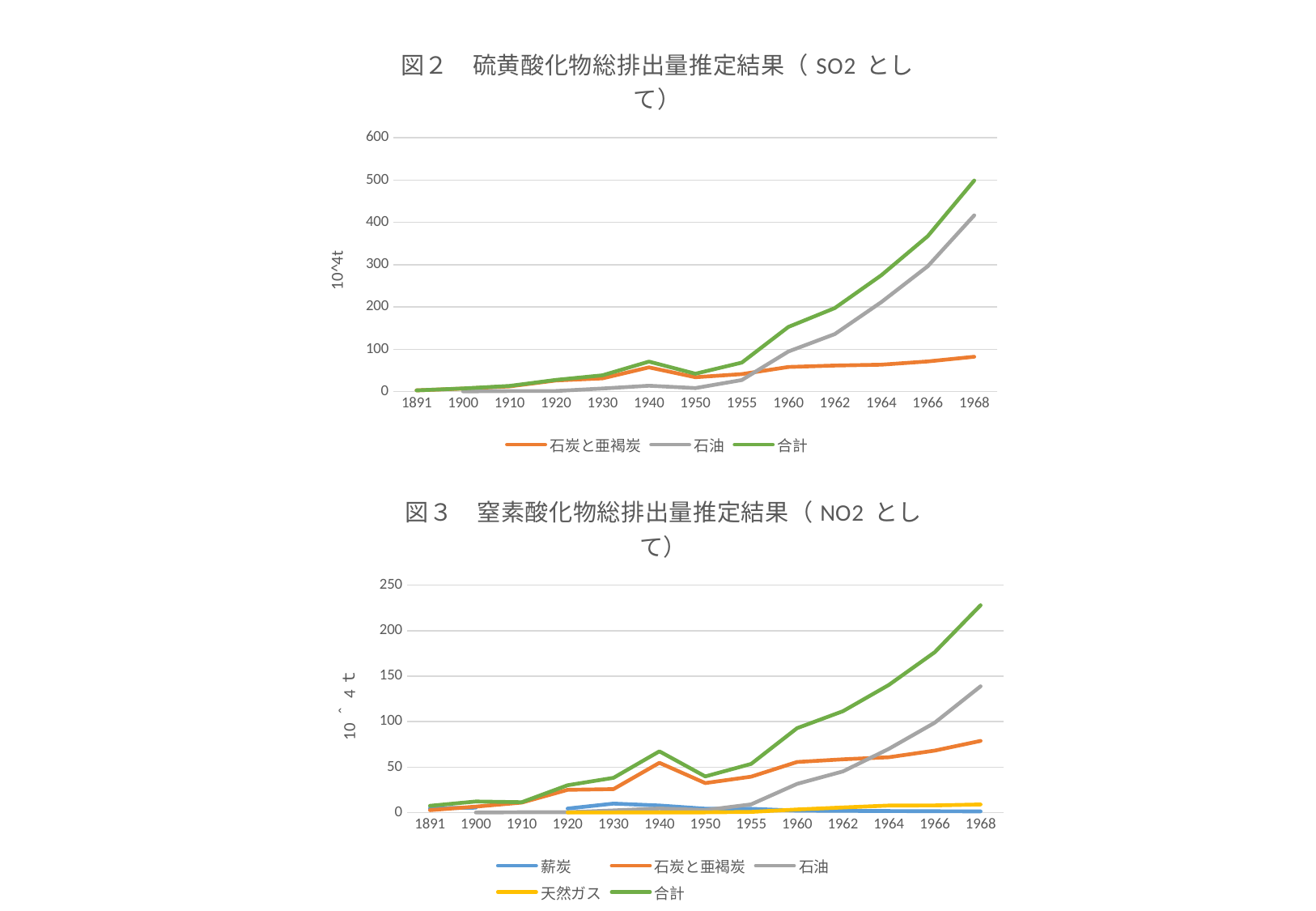
In the chart titled 図３ 窒素酸化物総排出量推定結果, is the value of 石油 in 1968 greater or less than 100? greater In the chart titled 図２ 硫黄酸化物総排出量推定結果, in which year does the 合計 series reach its highest value? 1968 In the chart titled 図２ 硫黄酸化物総排出量推定結果, how many series does the legend list? 3 In the chart titled 図３ 窒素酸化物総排出量推定結果, does the 合計 series generally rise or fall from 1950 to 1968? rise In the chart titled 図２ 硫黄酸化物総排出量推定結果, is the value of 合計 in 1968 greater or less than 400? greater In the chart titled 図２ 硫黄酸化物総排出量推定結果, which series has the higher value in 1968, 石油 or 石炭と亜褐炭? 石油 In the chart titled 図２ 硫黄酸化物総排出量推定結果, is the value of 石炭と亜褐炭 in 1968 greater or less than 100? less In the chart titled 図２ 硫黄酸化物総排出量推定結果, how many years are shown on the x axis? 13 In the chart titled 図３ 窒素酸化物総排出量推定結果, what colour is the 合計 line? green In the chart titled 図３ 窒素酸化物総排出量推定結果, how many series does the legend list? 5 In the chart titled 図２ 硫黄酸化物総排出量推定結果, what kind of chart is shown? line chart